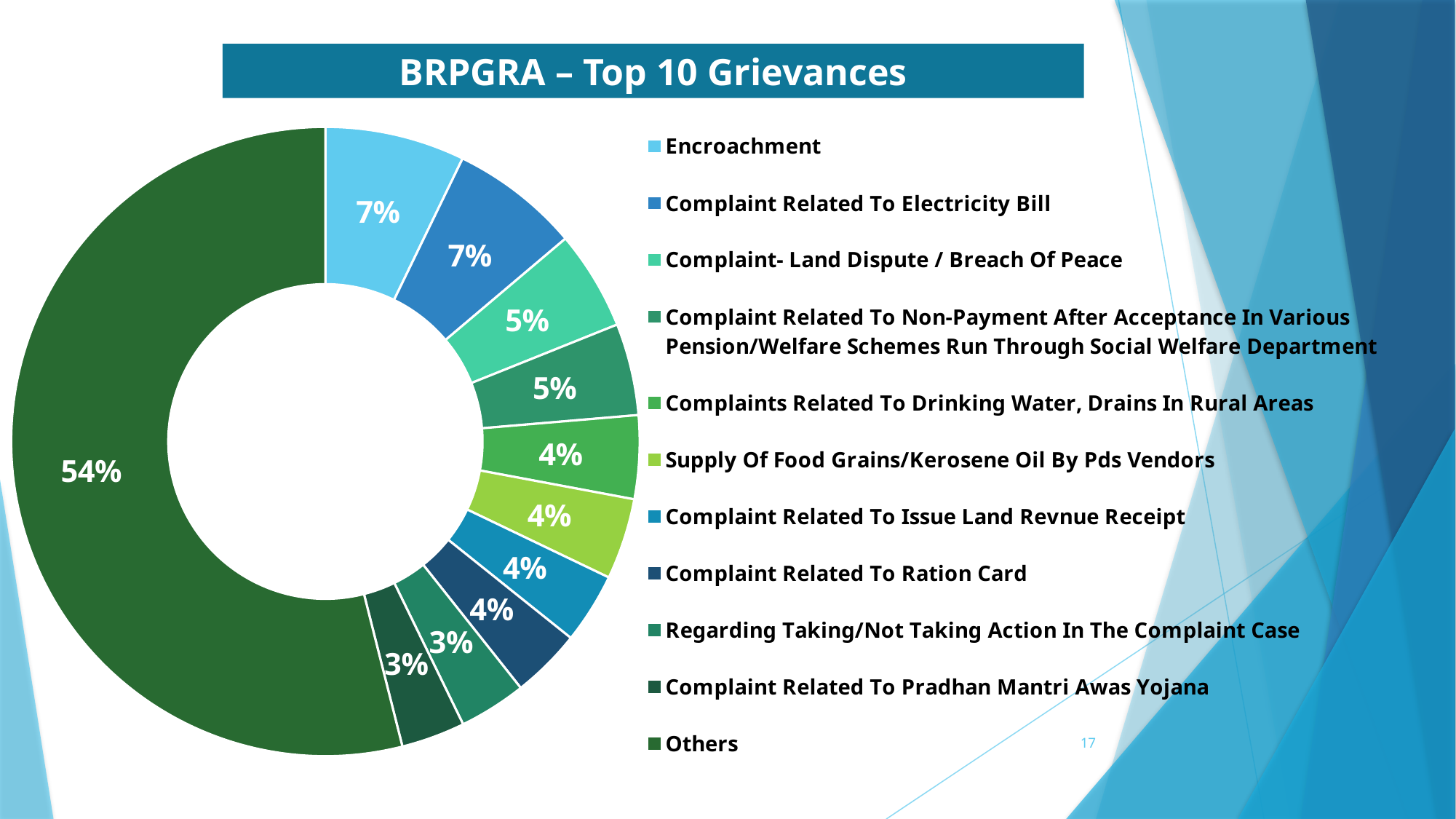
What is the title of the chart? BRPGRA – Top 10 Grievances What kind of chart is shown on the slide? Pie chart (donut) What percentage is shown for Complaint Related To Pradhan Mantri Awas Yojana? 3% What percentage is shown for Encroachment? 7% What share of grievances is labelled Others? 54% What percentage is shown for Complaint- Land Dispute / Breach Of Peace? 5% Which is larger, the share for Encroachment or the share for Complaint Related To Ration Card? Encroachment How many categories does the legend list? 11 What percentage is shown for Complaint Related To Ration Card? 4% What is the difference in percentage points between Others and Encroachment? 47 What percentage is shown for Complaint Related To Electricity Bill? 7% Which category has the largest share of the chart? Others